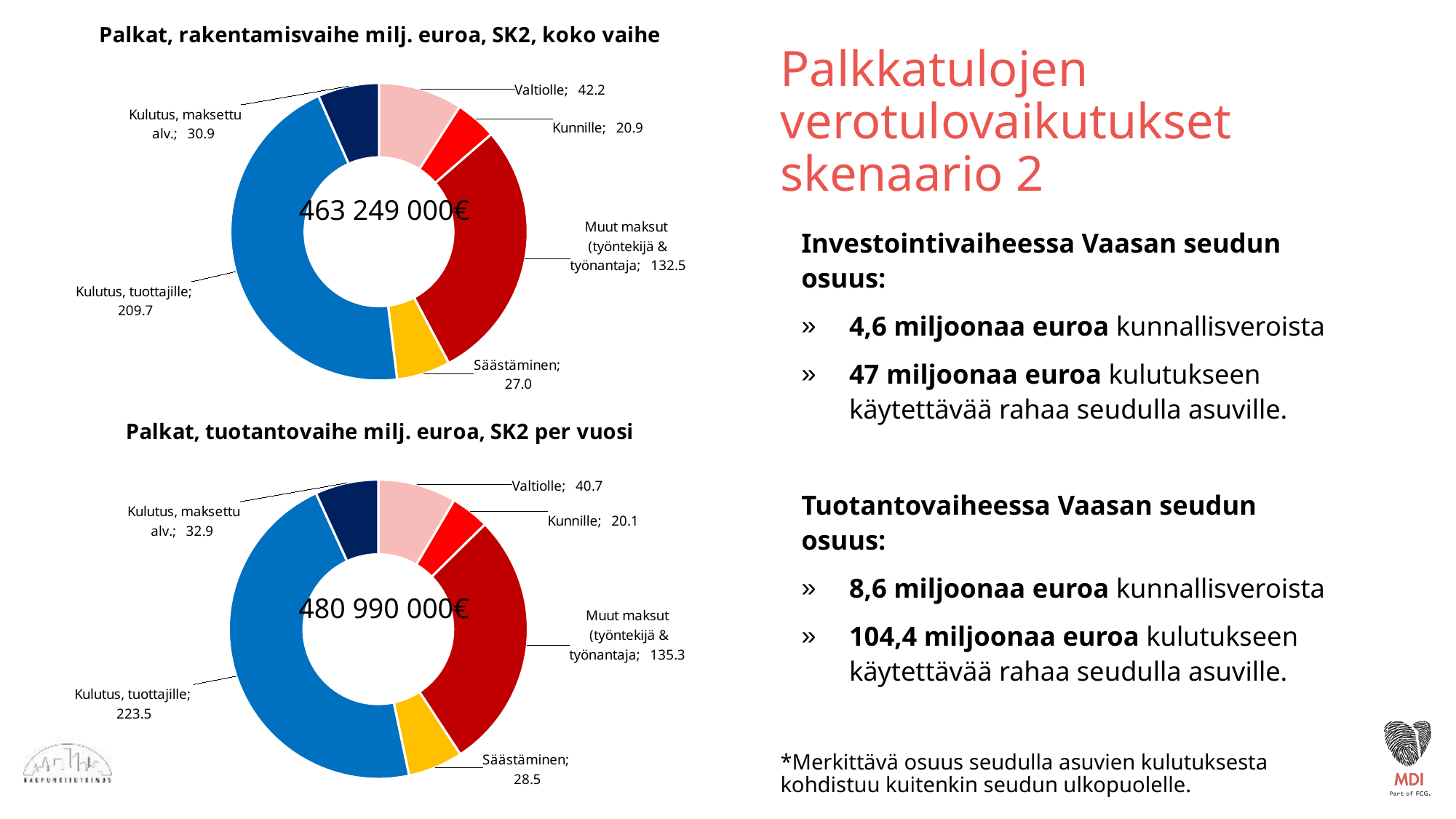
In the top chart (rakentamisvaihe), which category has the largest value? Kulutus, tuottajille In the bottom chart (tuotantovaihe), which category has the smallest value? Kunnille In the chart titled "Palkat, rakentamisvaihe milj. euroa, SK2, koko vaihe", what is the value for Kulutus, tuottajille? 209.7 What type of chart is used for "Palkat, tuotantovaihe milj. euroa, SK2 per vuosi"? Doughnut (pie) chart What total amount is printed in the centre of the bottom chart (tuotantovaihe)? 480 990 000€ In the top chart (rakentamisvaihe), what is the difference between Valtiolle and Kunnille? 21.3 In the top chart (rakentamisvaihe), what is the value for Kunnille? 20.9 In the bottom chart (tuotantovaihe), what is the value for Säästäminen? 28.5 What total amount is printed in the centre of the top chart (rakentamisvaihe)? 463 249 000€ In the bottom chart (tuotantovaihe), which is larger: Valtiolle or Kulutus, maksettu alv.? Valtiolle How many categories are shown in the top chart (rakentamisvaihe)? 6 In the chart titled "Palkat, tuotantovaihe milj. euroa, SK2 per vuosi", what is the value for Muut maksut (työntekijä & työnantaja)? 135.3